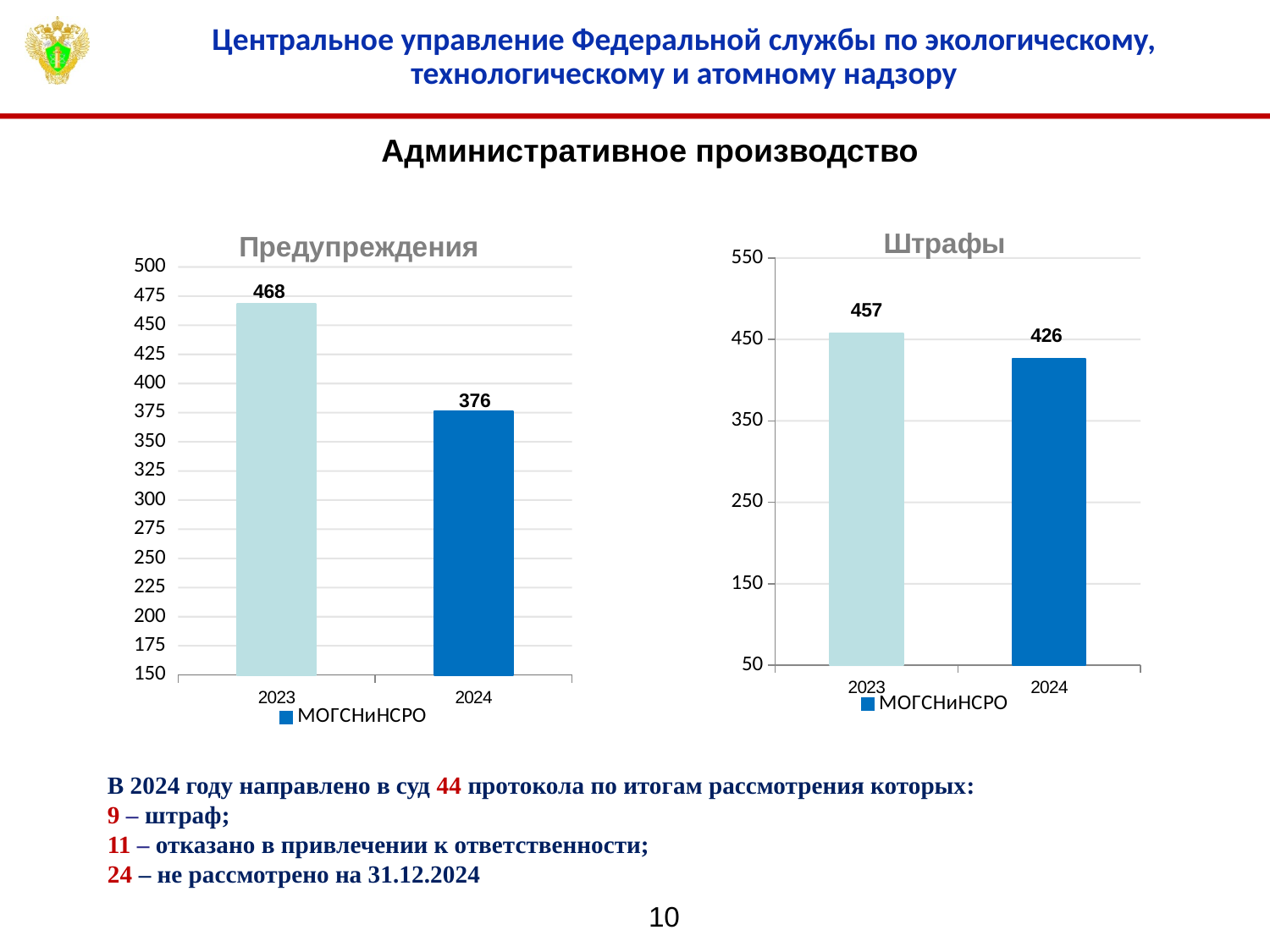
In the "Штрафы" chart, which year has the lower value? 2024 In the "Штрафы" chart, what is the difference between the 2023 and 2024 values? 31 In the "Предупреждения" chart, what is the difference between the 2023 and 2024 values? 92 In the "Предупреждения" chart, what is the value for 2024? 376 In the "Предупреждения" chart, what series name does the legend show? МОГСНиНСРО What kind of chart is the "Штрафы" chart? bar chart In the "Штрафы" chart, what is the value for 2024? 426 In the "Предупреждения" chart, what is the value for 2023? 468 In the "Штрафы" chart, what is the value for 2023? 457 In the "Штрафы" chart, is the value for 2024 greater or less than 450? less In the "Предупреждения" chart, do the values rise or fall from 2023 to 2024? fall In the "Предупреждения" chart, which year has the higher value? 2023